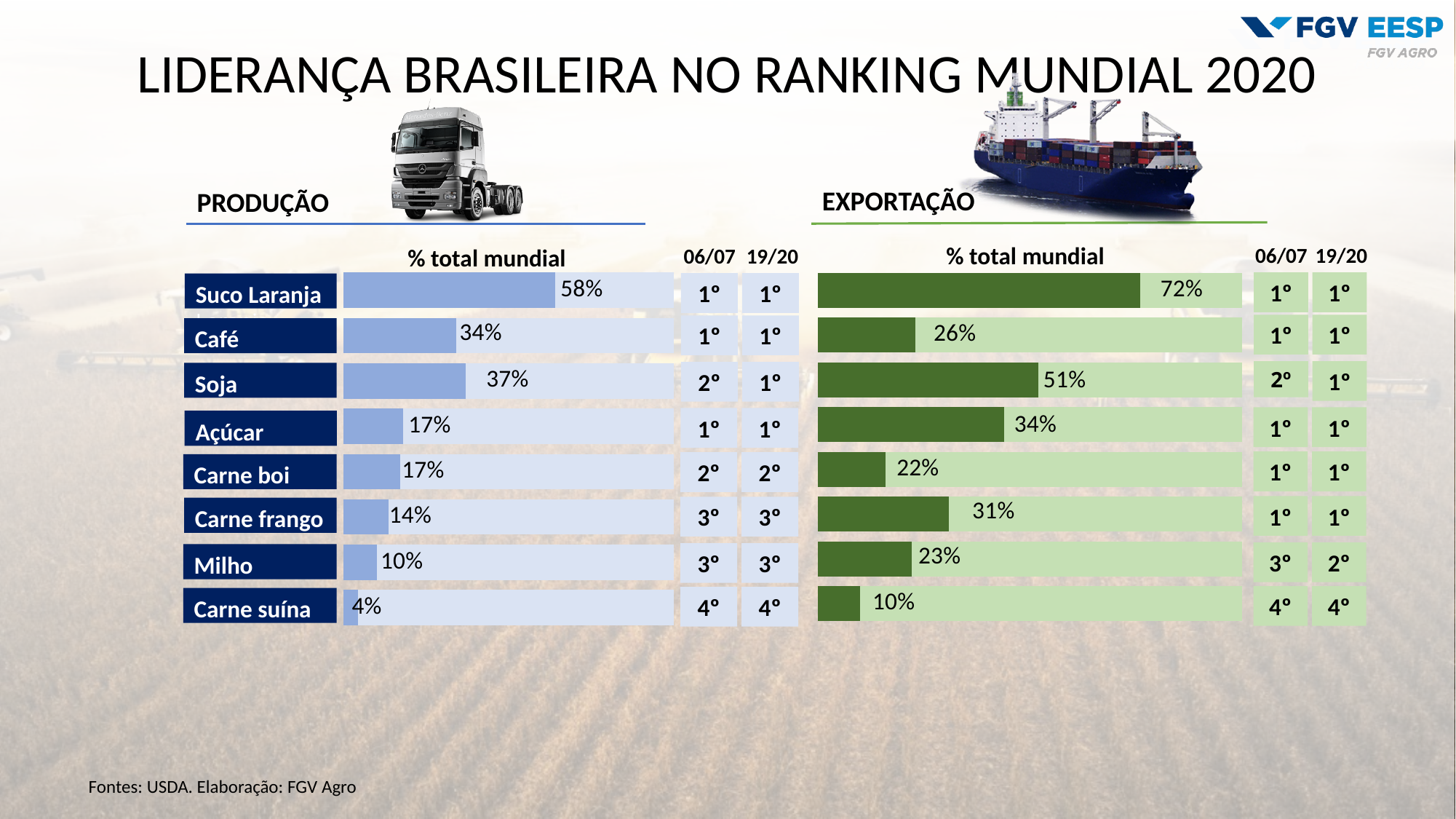
How many categories are shown in the PRODUÇÃO chart? 8 In the EXPORTAÇÃO chart, which is larger, the value for Açúcar or the value for Café? Açúcar In the PRODUÇÃO chart, what is the difference between the values for Café and Milho? 24% In the PRODUÇÃO chart, what is the value for Soja? 37% In the PRODUÇÃO chart, which category has the highest value? Suco Laranja In the PRODUÇÃO chart, what is the value for Carne suína? 4% In the EXPORTAÇÃO chart, which category has the lowest value? Carne suína In the PRODUÇÃO chart, which is larger, the value for Soja or the value for Café? Soja In the EXPORTAÇÃO chart, what is the value for Carne frango? 31% In the EXPORTAÇÃO chart, what is the difference between the values for Suco Laranja and Soja? 21% What is the title of the slide? LIDERANÇA BRASILEIRA NO RANKING MUNDIAL 2020 What kind of chart is the EXPORTAÇÃO chart? Bar chart